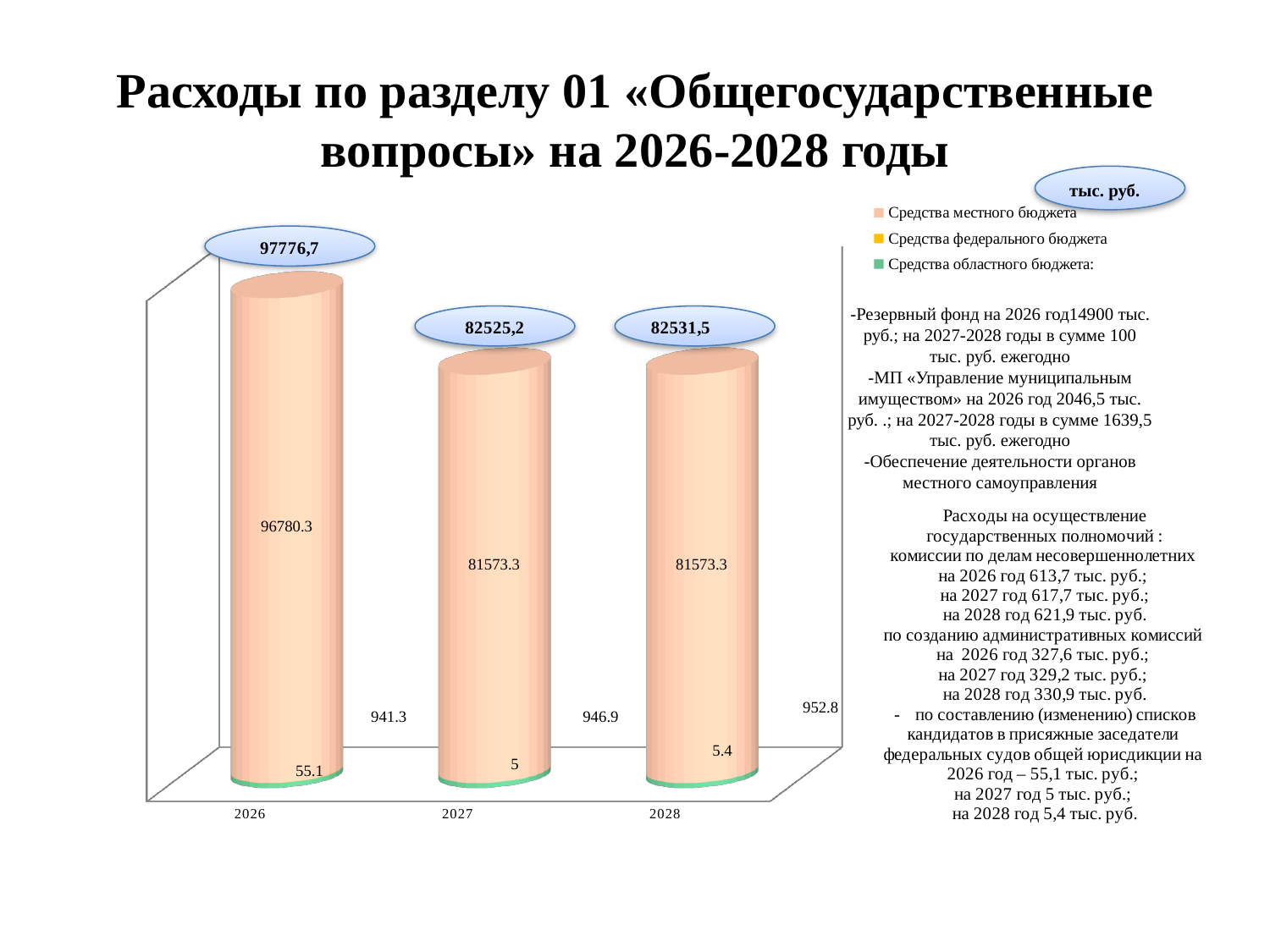
What is the value of Средства местного бюджета for 2027? 81573.3 What total is shown in the callout above the 2027 bar? 82525,2 How many series does the chart legend list? 3 Which year has the larger value for Средства местного бюджета, 2026 or 2027? 2026 By how much does the 2028 total (82531,5) exceed the 2027 total (82525,2)? 6,3 What kind of chart is shown on the slide? bar chart What is the value of Средства местного бюджета for 2026? 96780.3 Which year has the lowest total expenditure? 2027 What total is shown in the callout above the 2026 bar? 97776,7 What unit of measurement is shown in the callout at the top right of the chart? тыс. руб. How many years are shown on the x axis of the chart? 3 Which year has the highest total expenditure? 2026